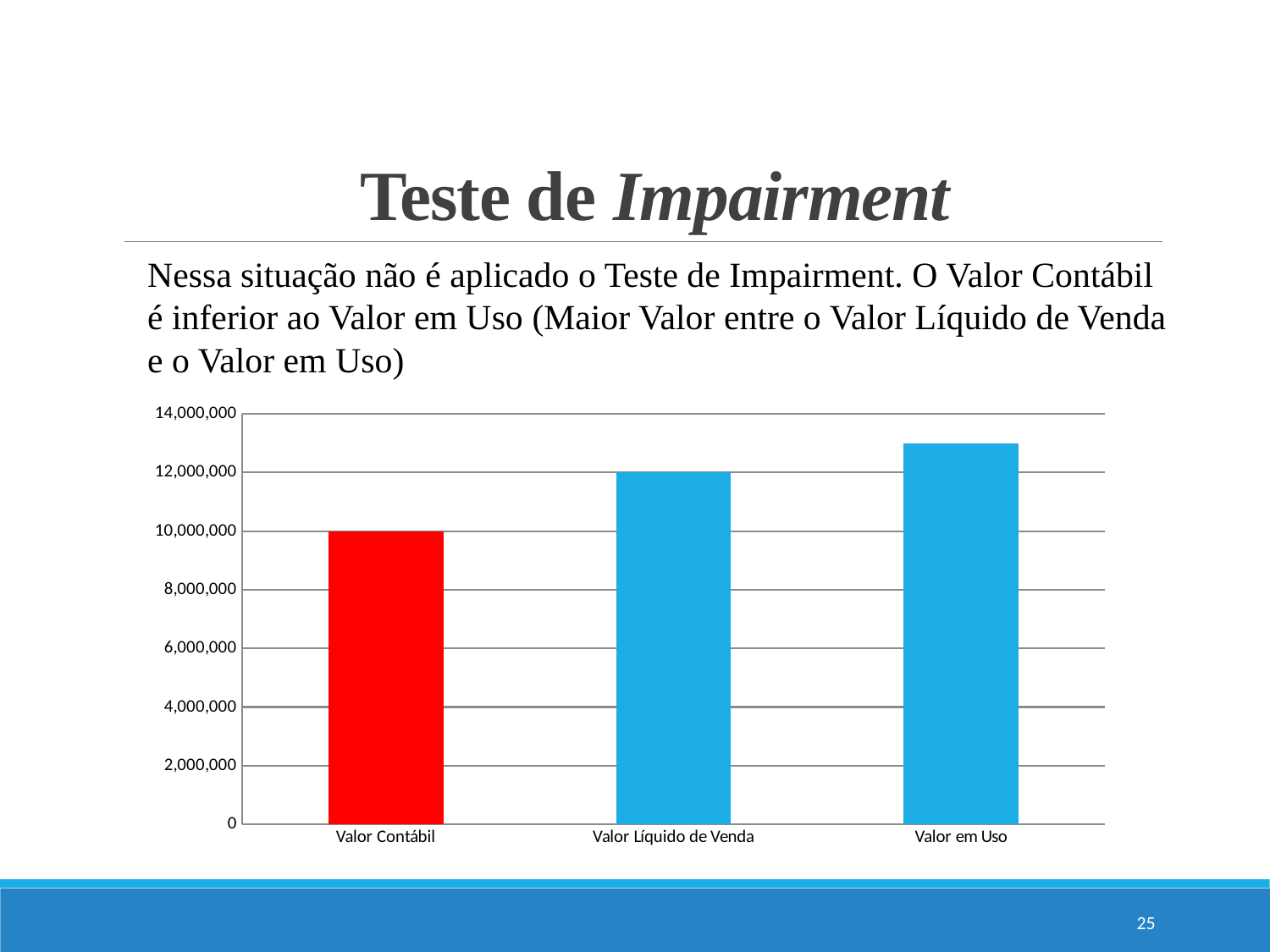
Is the value for Valor em Uso greater or less than 12,000,000? greater What is the value for Valor Líquido de Venda? 12,000,000 How many categories are shown on the x axis? 3 What is the difference between the values for Valor Líquido de Venda and Valor Contábil? 2,000,000 Which is larger, the value for Valor em Uso or the value for Valor Contábil? Valor em Uso Which bar is coloured red? Valor Contábil Which category has the lowest value? Valor Contábil Which category has the highest value? Valor em Uso Is the value for Valor em Uso greater or less than 14,000,000? less What is the value for Valor Contábil? 10,000,000 Do the values rise or fall from left to right along the x axis? rise What kind of chart is shown on the slide? bar chart